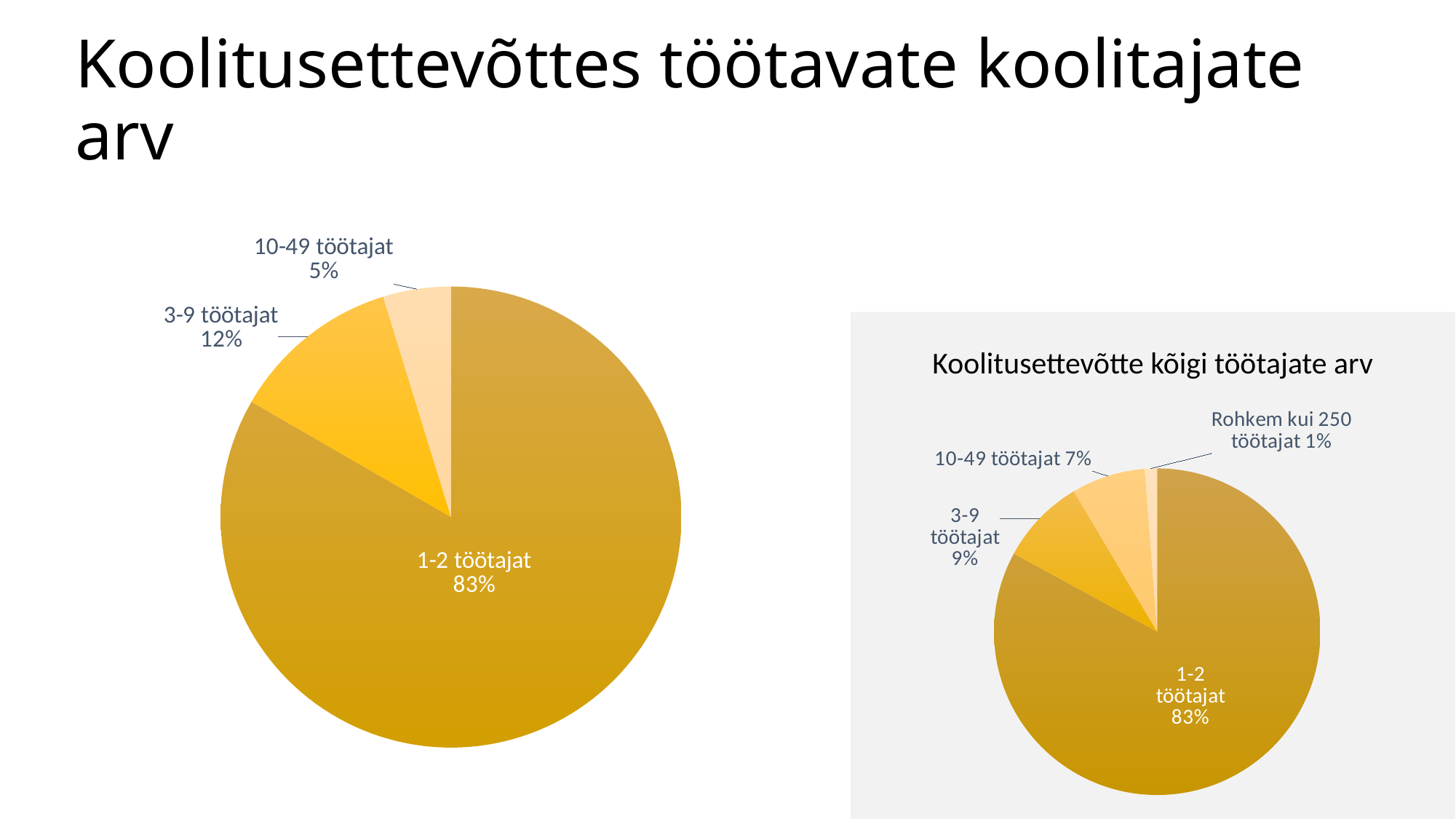
In the left pie chart, what is the difference between the shares for 3-9 töötajat and 10-49 töötajat? 7% In the chart titled 'Koolitusettevõtte kõigi töötajate arv', what share is labelled for Rohkem kui 250 töötajat? 1% In the left pie chart, what share is labelled for 10-49 töötajat? 5% In the left pie chart, which category has the smallest slice? 10-49 töötajat In the chart titled 'Koolitusettevõtte kõigi töötajate arv', what share is labelled for 10-49 töötajat? 7% How many slices does the left pie chart have? 3 In the chart titled 'Koolitusettevõtte kõigi töötajate arv', which category has the largest slice? 1-2 töötajat What type of chart is the chart titled 'Koolitusettevõtte kõigi töötajate arv'? Pie chart How many slices does the chart titled 'Koolitusettevõtte kõigi töötajate arv' have? 4